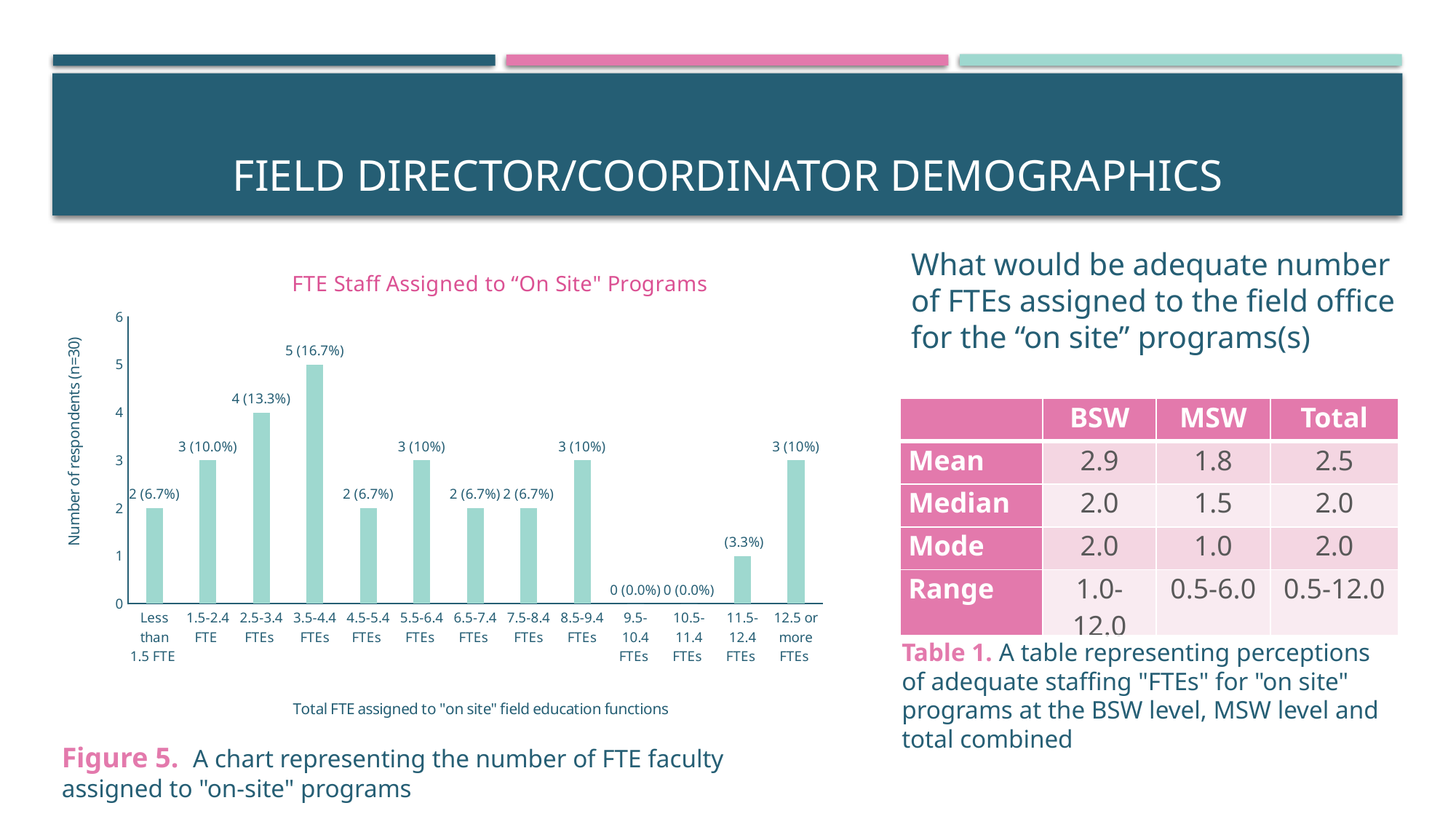
How many categories are shown on the x axis of the chart? 13 What is the data label for the 3.5-4.4 FTEs category? 5 (16.7%) What is the difference in number of respondents between the 3.5-4.4 FTEs category and the 4.5-5.4 FTEs category? 3 How many respondents are in the 1.5-2.4 FTE category? 3 How many respondents are in the 9.5-10.4 FTEs category? 0 What is the data label for the 2.5-3.4 FTEs category? 4 (13.3%) Which category has the highest number of respondents? 3.5-4.4 FTEs Which has more respondents, the 2.5-3.4 FTEs category or the 12.5 or more FTEs category? 2.5-3.4 FTEs What is the y-axis label of the chart? Number of respondents (n=30) What percentage is shown for the 11.5-12.4 FTEs category? 3.3% What is the title of the chart? FTE Staff Assigned to "On Site" Programs What type of chart is shown on the slide? bar chart